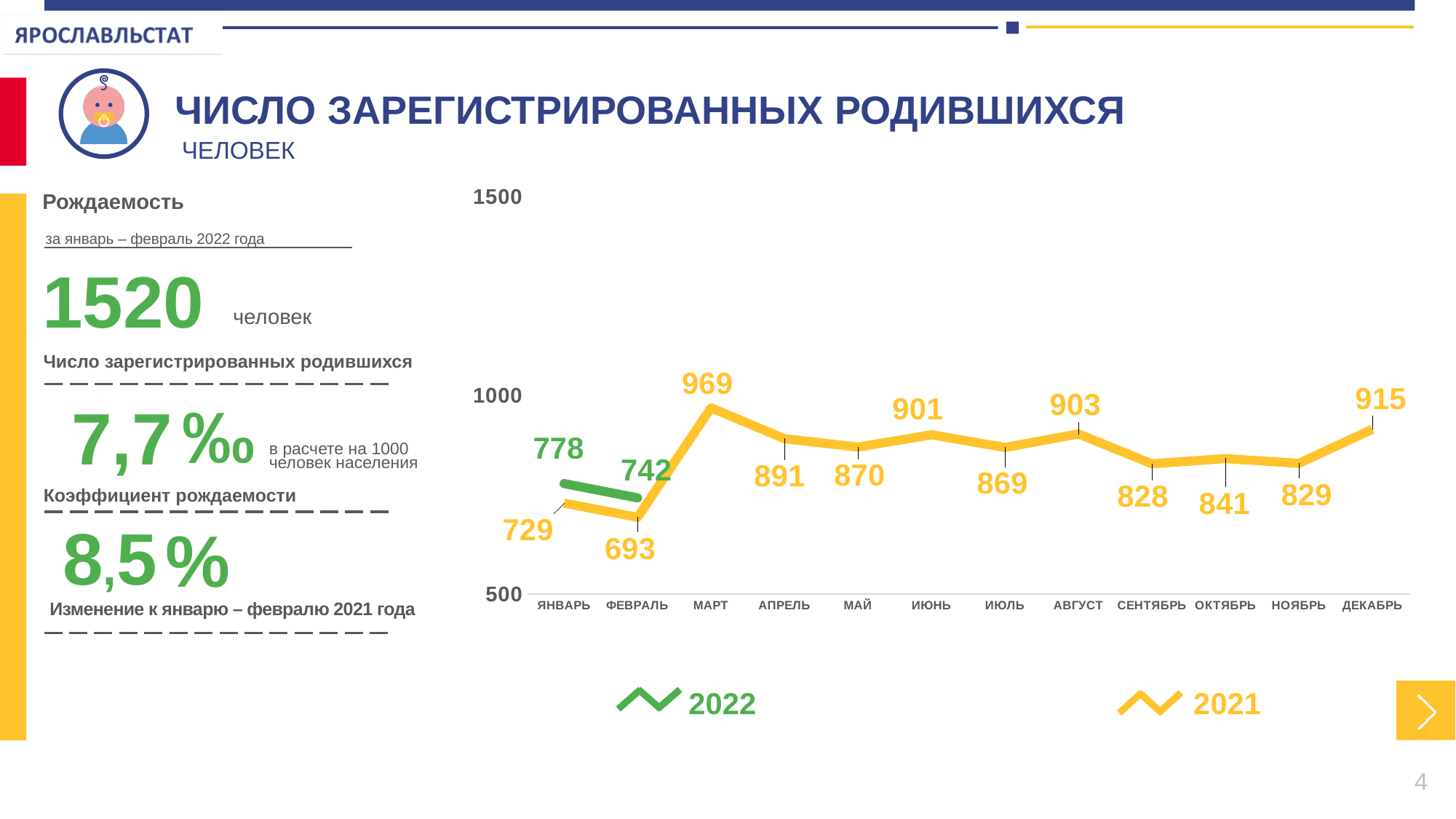
What is the value for 2021 in ДЕКАБРЬ? 915 How many months are shown on the x axis? 12 What is the value for 2021 in МАРТ? 969 How many series does the legend list? 2 What is the difference between the 2022 and 2021 values in ФЕВРАЛЬ? 49 Is the value for 2021 in МАЙ greater or less than 1000? less What is the value for 2022 in ЯНВАРЬ? 778 Which is larger in ЯНВАРЬ: the 2022 value or the 2021 value? 2022 In which month is the 2021 series highest? МАРТ In which month is the 2021 series lowest? ФЕВРАЛЬ What kind of chart is shown? line chart Does the 2021 series rise or fall from ФЕВРАЛЬ to МАРТ? rise